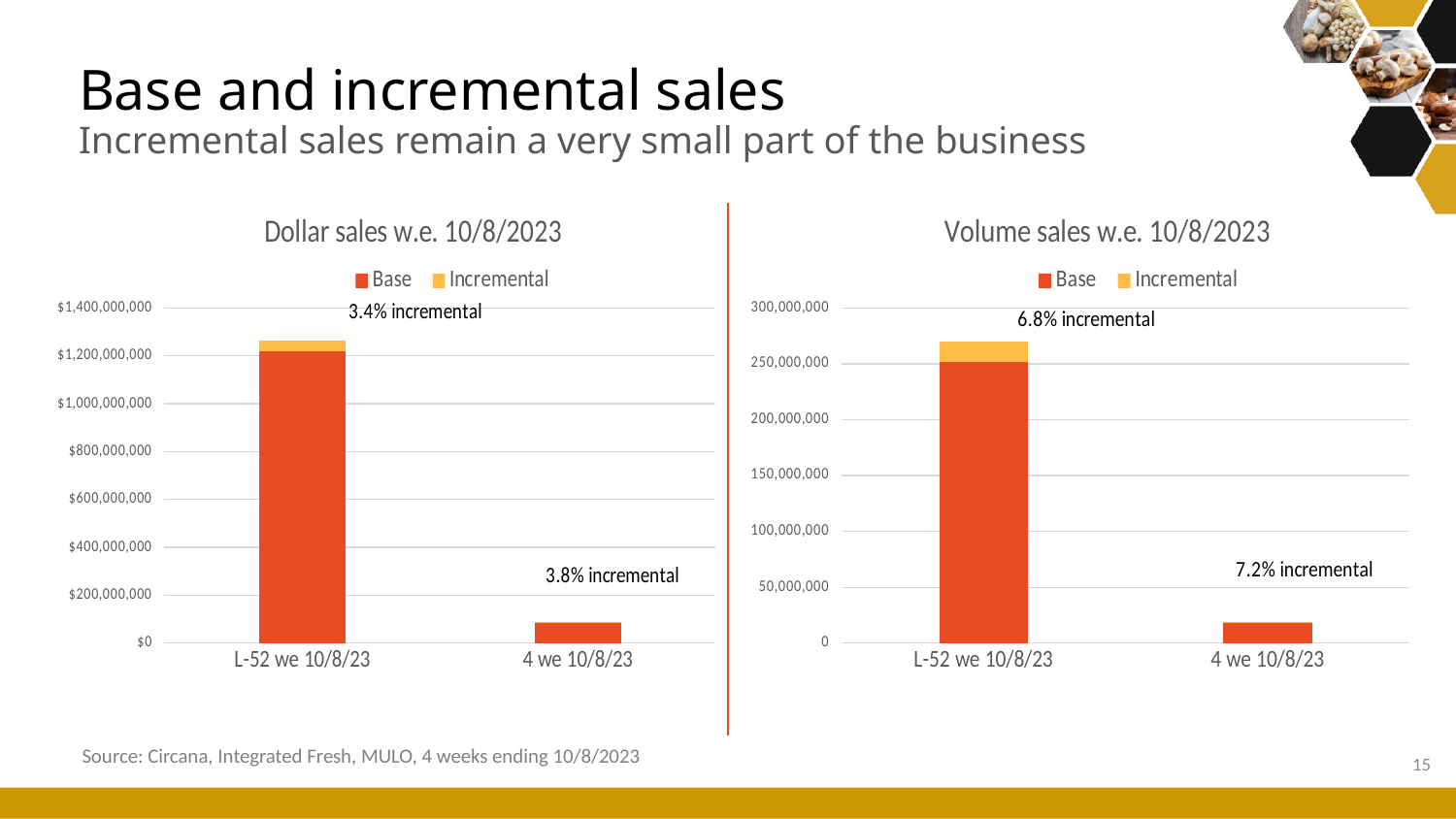
On the 'Volume sales w.e. 10/8/2023' chart, what percentage is labelled as incremental for L-52 we 10/8/23? 6.8% incremental What kind of chart is the 'Dollar sales w.e. 10/8/2023' chart? Stacked bar chart On the 'Dollar sales w.e. 10/8/2023' chart, is the Base value for L-52 we 10/8/23 greater or less than $1,000,000,000? greater On the 'Volume sales w.e. 10/8/2023' chart, is the Base value for L-52 we 10/8/23 greater or less than 200,000,000? greater How many categories are shown on the x axis of the 'Dollar sales w.e. 10/8/2023' chart? 2 On the 'Dollar sales w.e. 10/8/2023' chart, is the total bar for 4 we 10/8/23 greater or less than $200,000,000? less How many series does the legend list on the 'Volume sales w.e. 10/8/2023' chart? 2 On the 'Dollar sales w.e. 10/8/2023' chart, what percentage of sales is labelled as incremental for 4 we 10/8/23? 3.8% incremental On the 'Dollar sales w.e. 10/8/2023' chart, which colour represents the Incremental series? Yellow On the 'Volume sales w.e. 10/8/2023' chart, which category has the taller bar, L-52 we 10/8/23 or 4 we 10/8/23? L-52 we 10/8/23 On the 'Dollar sales w.e. 10/8/2023' chart, what percentage of sales is labelled as incremental for L-52 we 10/8/23? 3.4% incremental On the 'Volume sales w.e. 10/8/2023' chart, what percentage is labelled as incremental for 4 we 10/8/23? 7.2% incremental